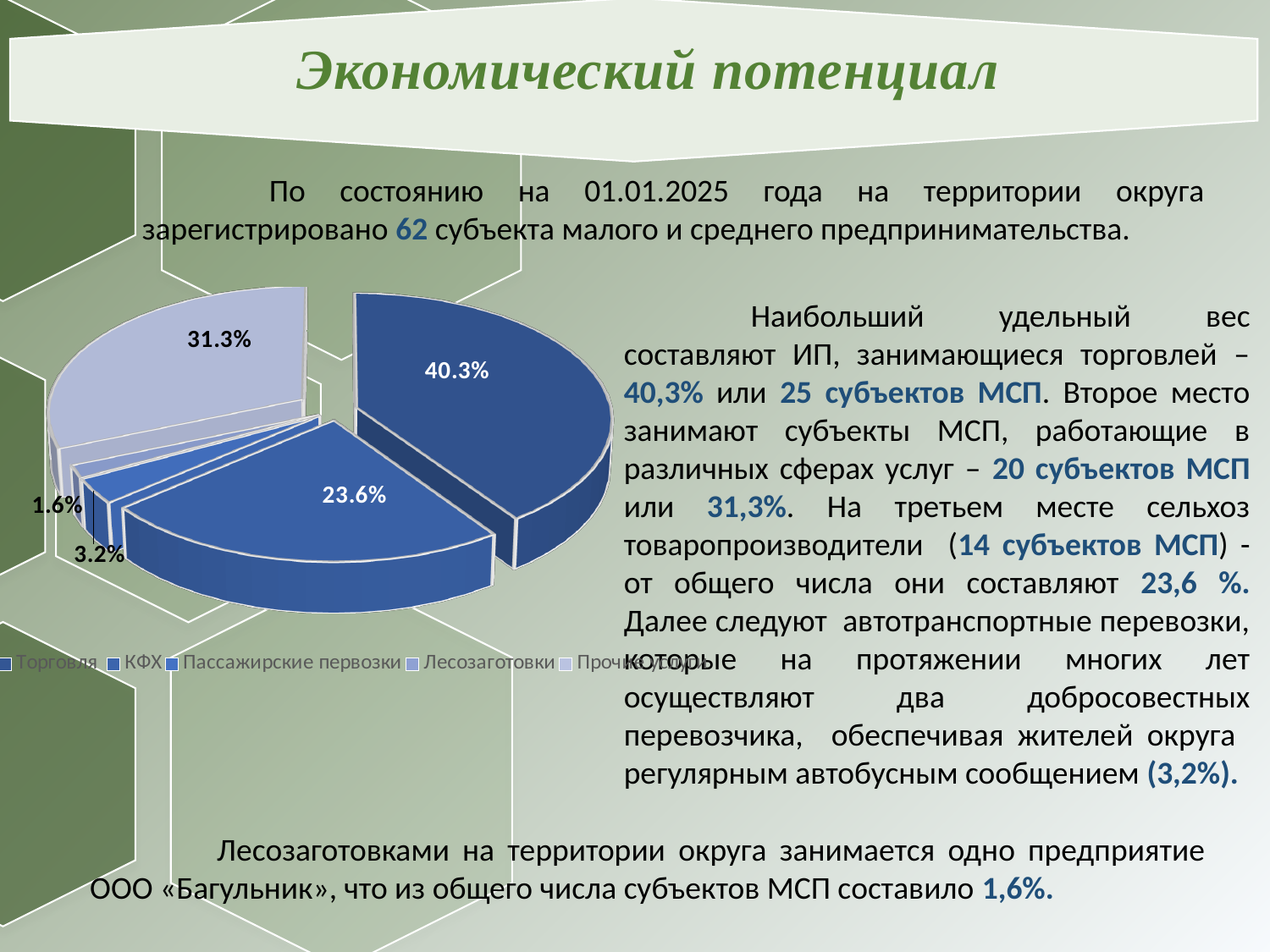
What percentage is shown for the Пассажирские первозки slice? 3.2% What is the difference in percentage points between the Торговля slice and the КФХ slice? 16.7 Which category has the largest slice of the pie? Торговля Which slice is larger, the 31.3% slice or the 23.6% slice? 31.3% What kind of chart is shown on the slide? pie chart What share of the pie does the Торговля slice represent? 40.3% How many entries does the legend list? 5 How many slices does the pie chart have? 5 Which category has the smallest slice of the pie? Лесозаготовки What is the combined share of the Пассажирские первозки and Лесозаготовки slices? 4.8% What percentage is shown for the Лесозаготовки slice? 1.6% What percentage is shown for the КФХ slice? 23.6%